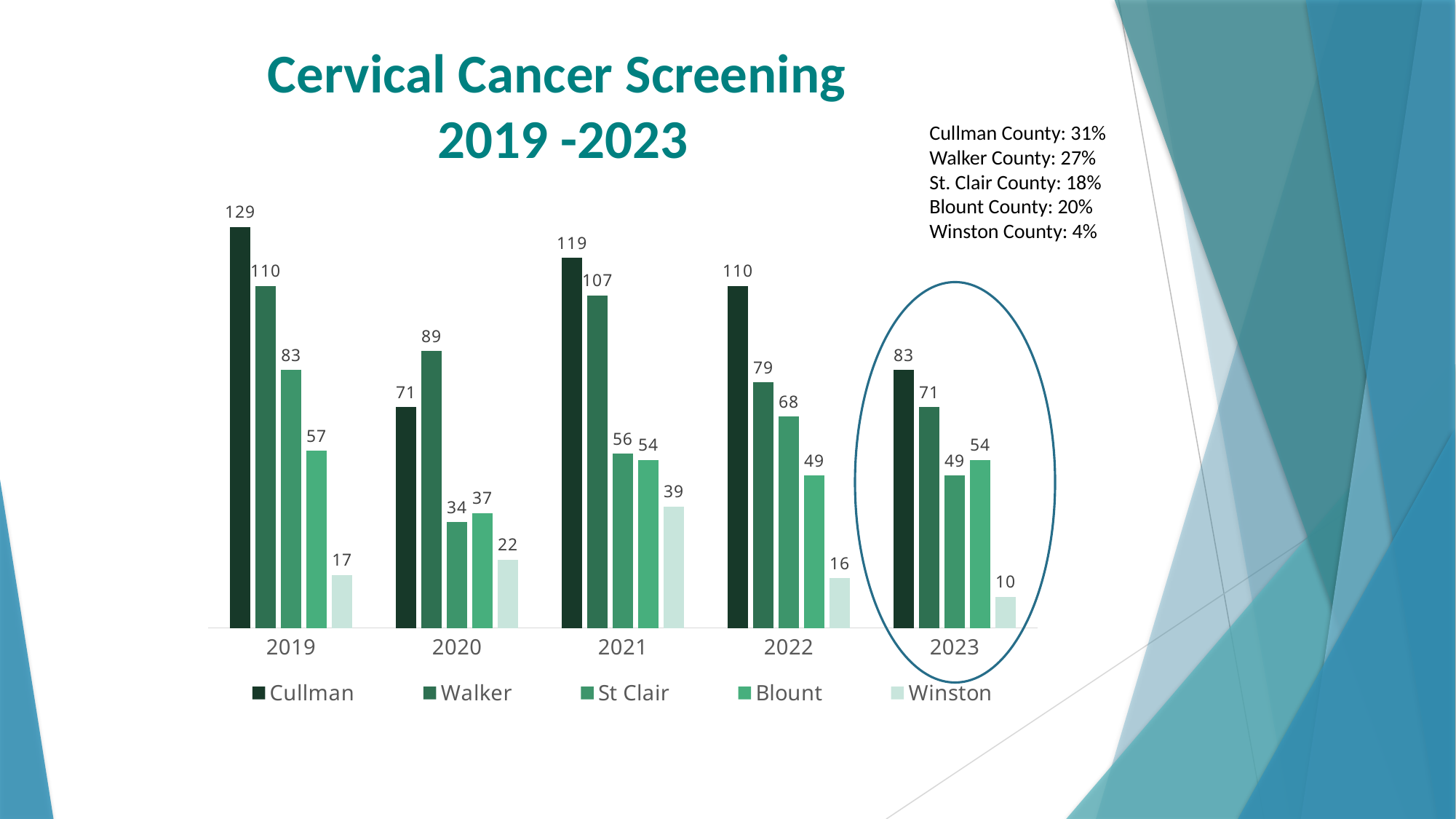
Which year has the highest Cullman value? 2019 Which is larger in 2020, the Cullman value or the Walker value? Walker What is the value for Walker in 2020? 89 What is the value for Cullman in 2019? 129 What kind of chart is shown on the slide? Bar chart What is the difference between the Cullman and Walker values in 2022? 31 How many series does the legend list? 5 Which county has the lowest value in 2021? Winston Which year is circled on the chart? 2023 How many years are shown on the x axis? 5 Does the Winston value rise or fall from 2021 to 2023? Fall What is the value for Winston in 2023? 10